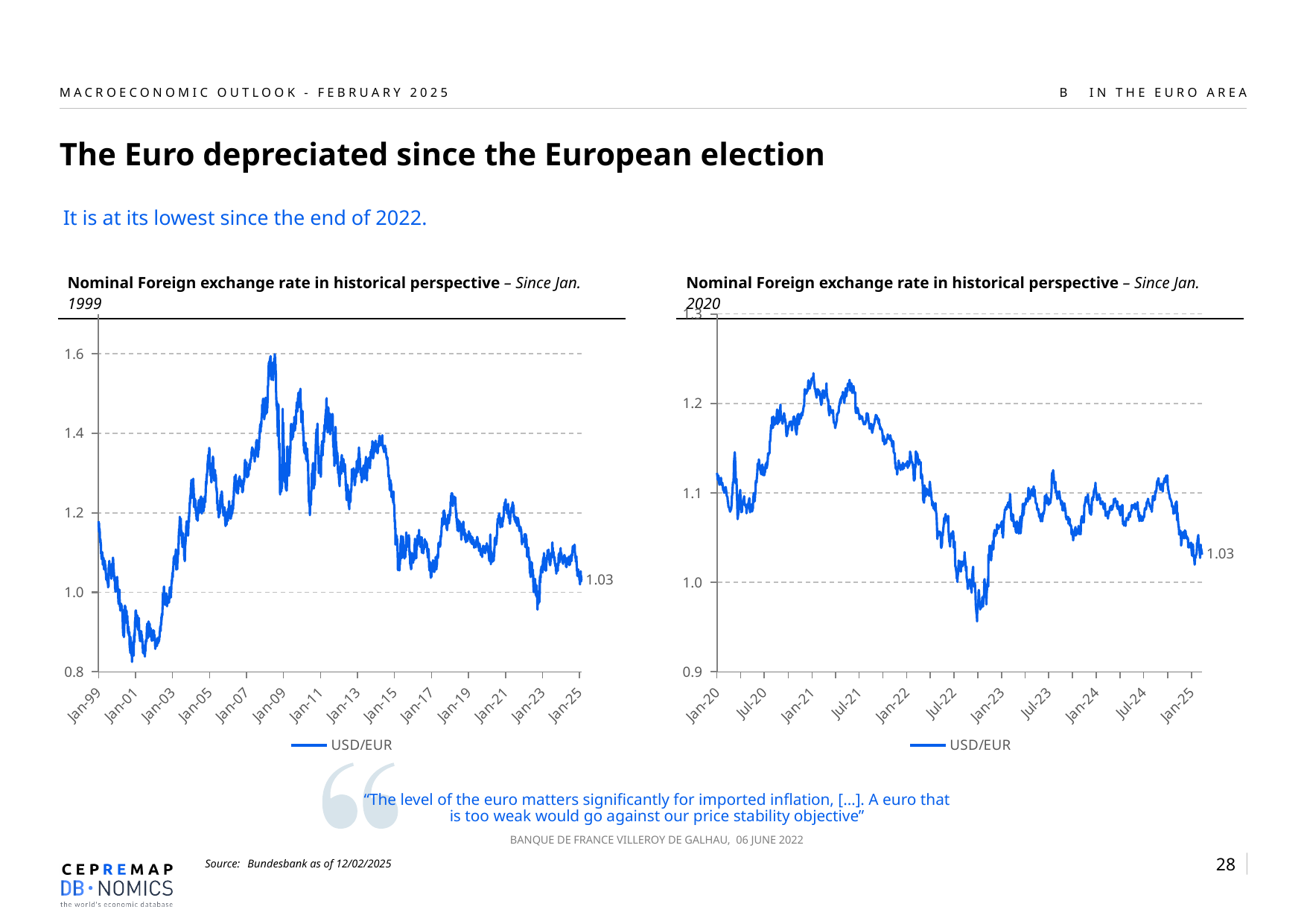
In the right chart (since Jan. 2020), what is the value labelled at the end of the USD/EUR series? 1.03 How many series does the legend of the left chart (since Jan. 1999) list? 1 In the left chart (since Jan. 1999), what is the value labelled at the end of the USD/EUR series? 1.03 In the left chart (since Jan. 1999), is the USD/EUR value higher around Jan-09 or around Jan-25? Jan-09 In the right chart (since Jan. 2020), is the USD/EUR value around Jan-21 greater or less than 1.2? greater In the left chart (since Jan. 1999), is the USD/EUR value around Jan-01 greater or less than 1.0? less What kind of chart is the left chart, 'Nominal Foreign exchange rate in historical perspective – Since Jan. 1999'? line chart What kind of chart is the right chart, 'Nominal Foreign exchange rate in historical perspective – Since Jan. 2020'? line chart In the right chart (since Jan. 2020), is the USD/EUR value around Jan-23 greater or less than 1.0? greater What series name is shown in the legend of the right chart (since Jan. 2020)? USD/EUR In the right chart (since Jan. 2020), does the USD/EUR series rise or fall between Jul-24 and Jan-25? fall